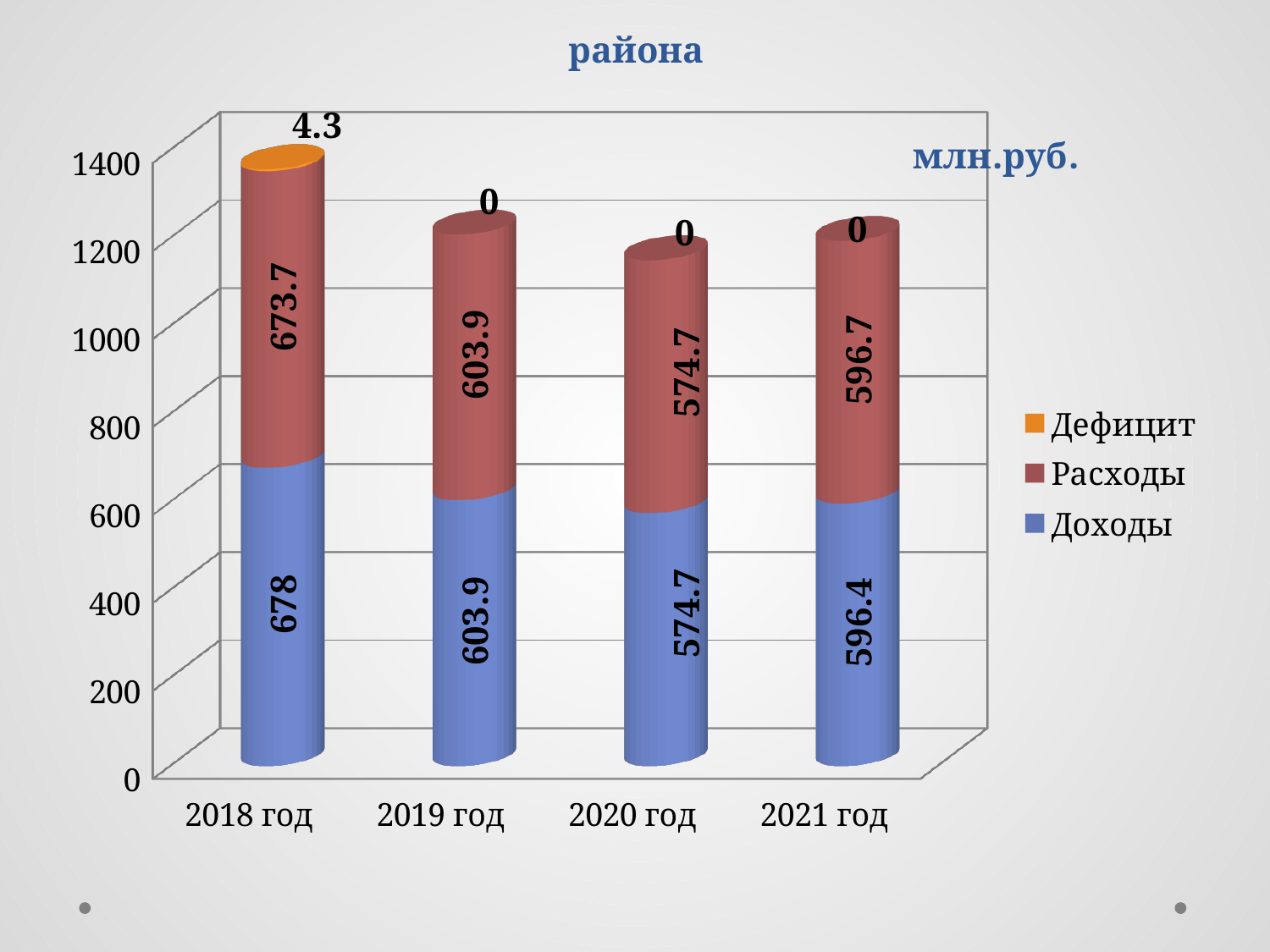
What is the value of Расходы for 2020 год? 574.7 What is the value of Расходы for 2021 год? 596.7 What is the total of the stacked bar for 2019 год? 1207.8 What is the difference between Доходы and Расходы for 2018 год? 4.3 How many series does the legend list? 3 What is the value of Доходы for 2018 год? 678 What kind of chart is shown on the slide? Stacked bar chart Which year has the lowest value of Расходы? 2020 год Which year has the highest value of Доходы? 2018 год How many years are shown on the x axis? 4 Which is larger for 2021 год, Доходы or Расходы? Расходы What is the value of Дефицит for 2018 год? 4.3